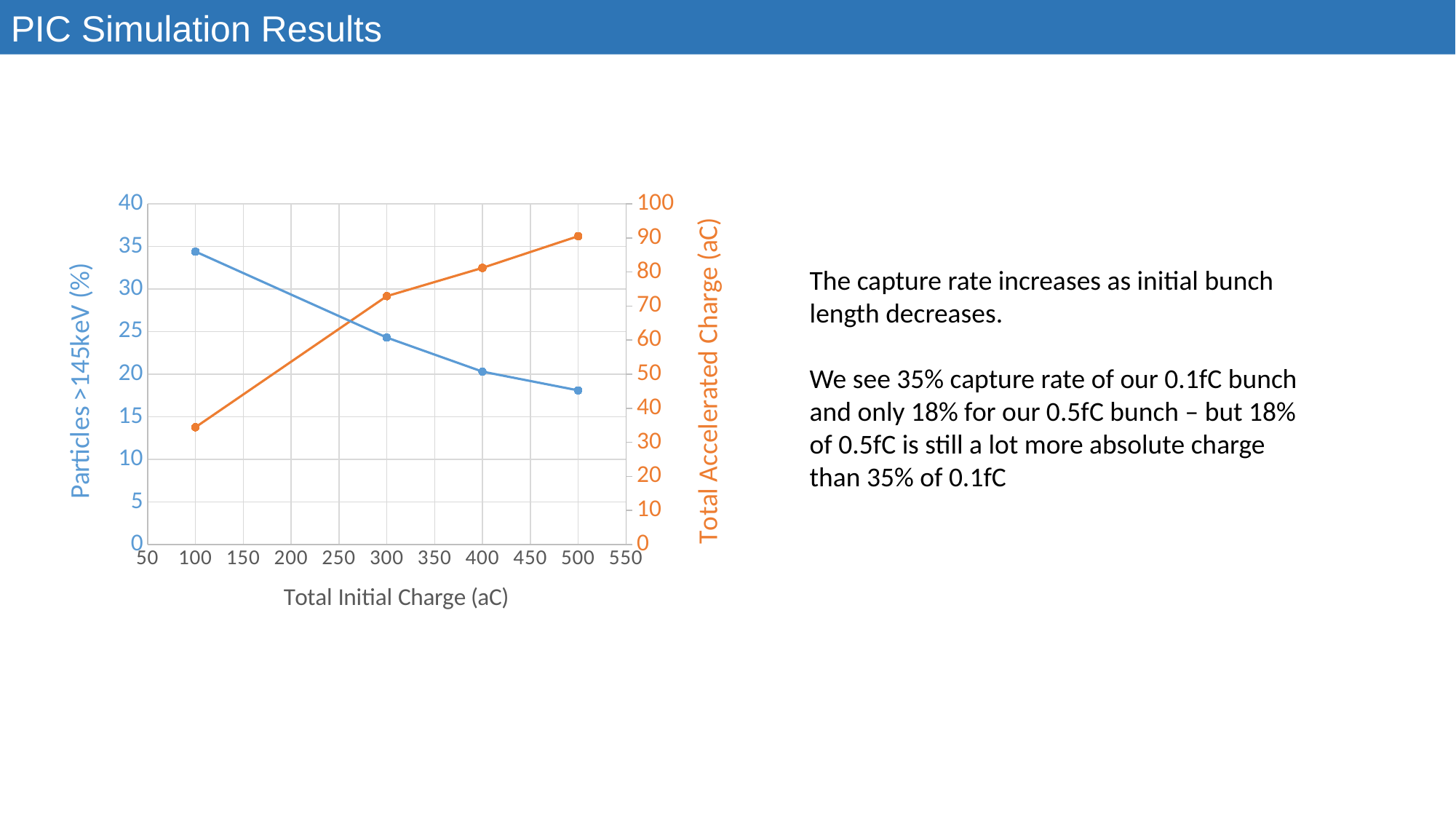
What is the label of the x axis of the chart? Total Initial Charge (aC) Is the Particles >145keV (%) value at Total Initial Charge 100 greater or less than 30? greater Does the Particles >145keV (%) series rise or fall as Total Initial Charge increases? fall Is the Total Accelerated Charge (aC) value at Total Initial Charge 500 greater or less than 80? greater What kind of chart is shown on the slide? line chart Does the Total Accelerated Charge (aC) series rise or fall as Total Initial Charge increases? rise At which Total Initial Charge is Particles >145keV (%) highest? 100 How many data points are plotted for each series in the chart? 4 Is the Particles >145keV (%) value at Total Initial Charge 500 greater or less than 20? less At which Total Initial Charge is Total Accelerated Charge (aC) highest? 500 What is the label of the right-hand (orange) y axis? Total Accelerated Charge (aC) At which Total Initial Charge is Particles >145keV (%) lowest? 500